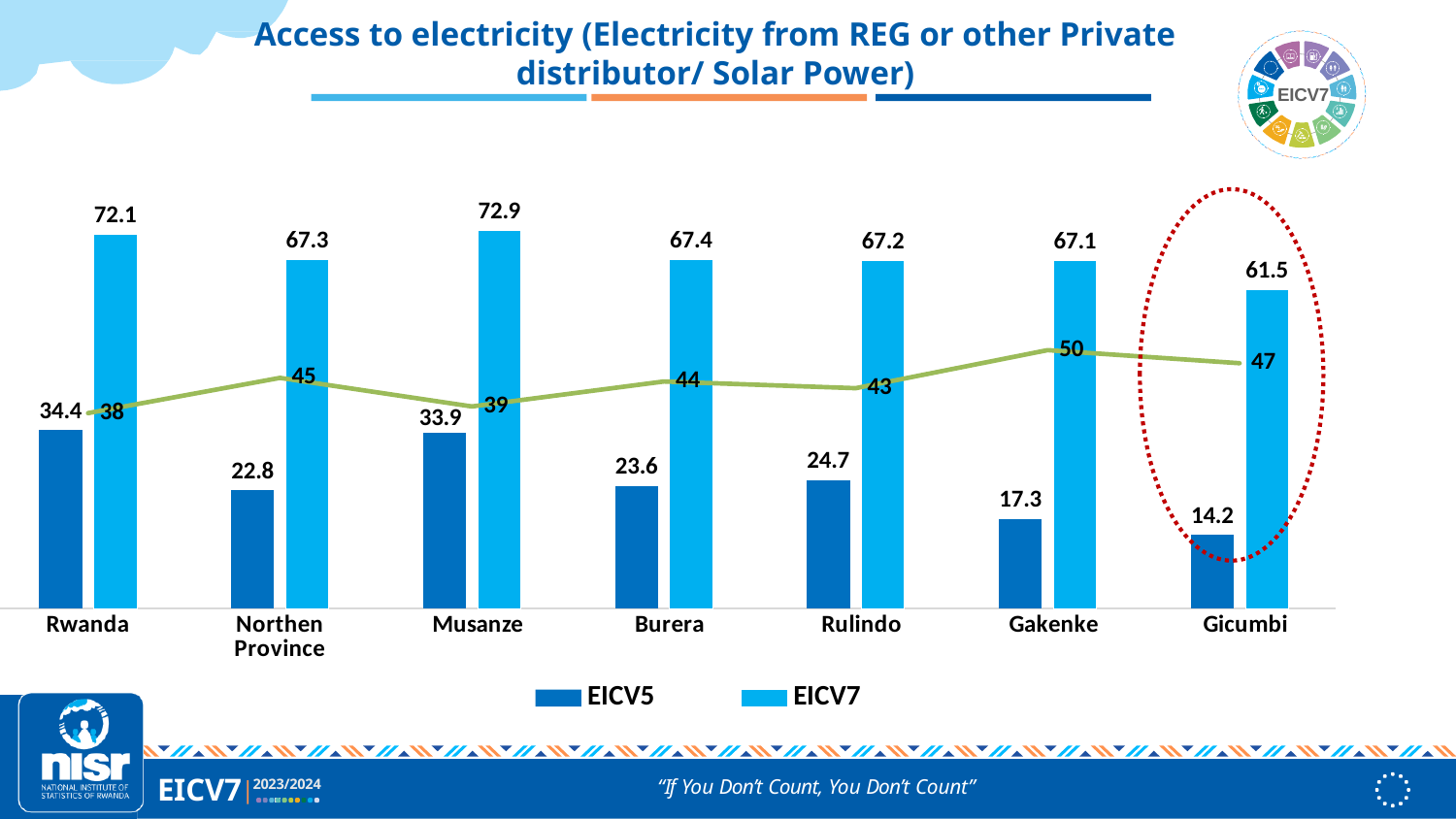
Which category has the highest EICV7 value? Musanze What kind of chart is shown on the slide? Combination bar and line chart How many categories are shown on the x axis? 7 What is the EICV5 value for Gakenke? 17.3 What is the difference between the EICV7 and EICV5 values for Rwanda? 37.7 Which category has the lowest EICV5 value? Gicumbi What is the difference between the EICV5 values for Rwanda and Northen Province? 11.6 How many series does the legend list? 2 What is the EICV7 value for Musanze? 72.9 What is the EICV7 value for Gicumbi? 61.5 Which is larger, the EICV5 value for Burera or the EICV5 value for Rulindo? Rulindo Which category is circled with a red dotted outline on the chart? Gicumbi